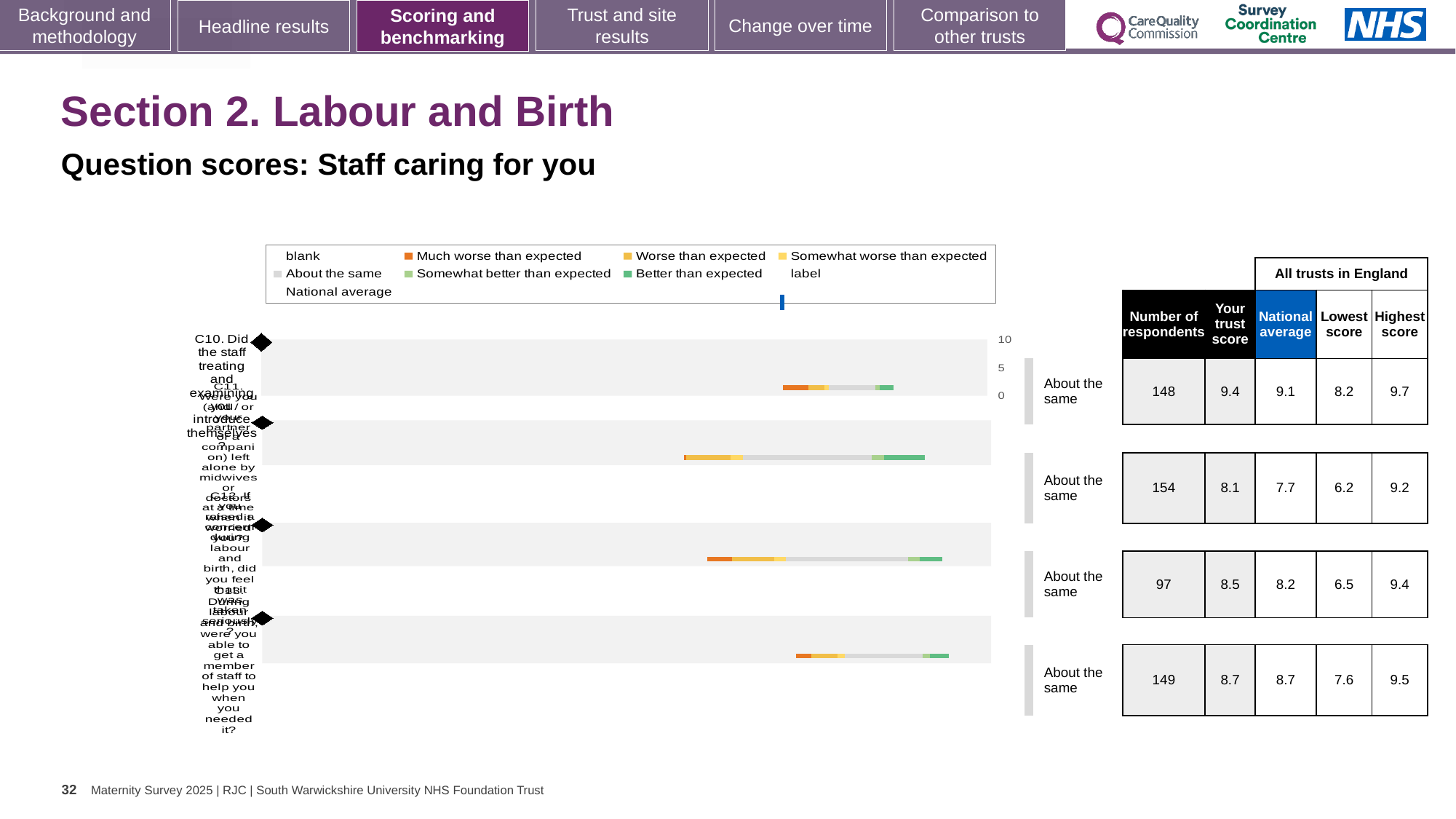
For the second row (C11), what is the difference between the trust score and the national average? 0.4 For the second row (C11), what is the difference between the highest score and the lowest score? 3.0 Which row has the highest 'Your trust score'? C10 (first row), 9.4 Which row has the lowest number of respondents? C12 (third row), 97 What is the highest score among all trusts in England for the fourth row (C13)? 9.5 How many question rows (C10 to C13) are plotted in the chart? 4 What benchmark category label is shown next to each of the four rows? About the same What is the 'Your trust score' value for the second row (C11)? 8.1 What is the national average for the third row (C12)? 8.2 For the first row (C10), which is larger: the trust score or the national average? the trust score (9.4) What type of chart is shown on the slide? bar chart In the table beside the chart, what is the number of respondents for the first row (C10)? 148